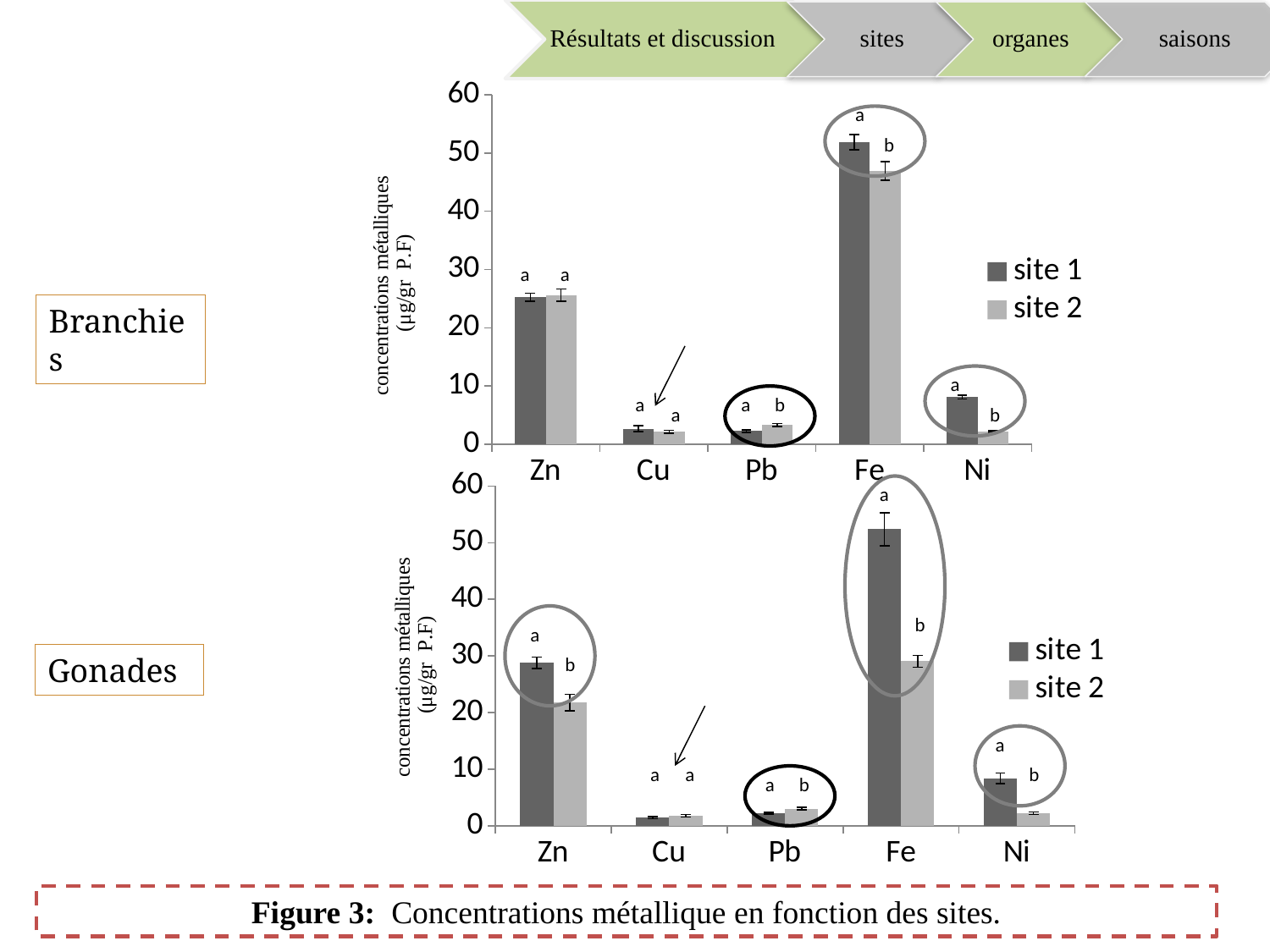
What kind of chart is the Branchies chart (top)? bar chart What are the two legend entries in the Branchies chart (top)? site 1, site 2 In the Branchies chart (top), which is larger for Ni: site 1 or site 2? site 1 What is the y-axis label of the Gonades chart (bottom)? concentrations métalliques (µg/gr P.F) In the Branchies chart (top), is the value for Fe at site 1 greater or less than 40? greater In the Gonades chart (bottom), is the value for Zn at site 2 greater or less than 30? less How many metal categories are shown on the x axis of the Branchies chart (top)? 5 In the Gonades chart (bottom), which is larger for Fe: site 1 or site 2? site 1 In the Branchies chart (top), which metal has the highest concentration for site 1? Fe In the Gonades chart (bottom), is the value for Fe at site 2 greater or less than 20? greater In the Gonades chart (bottom), which metal has the highest concentration for site 2? Fe How many series does the legend of the Gonades chart (bottom) list? 2